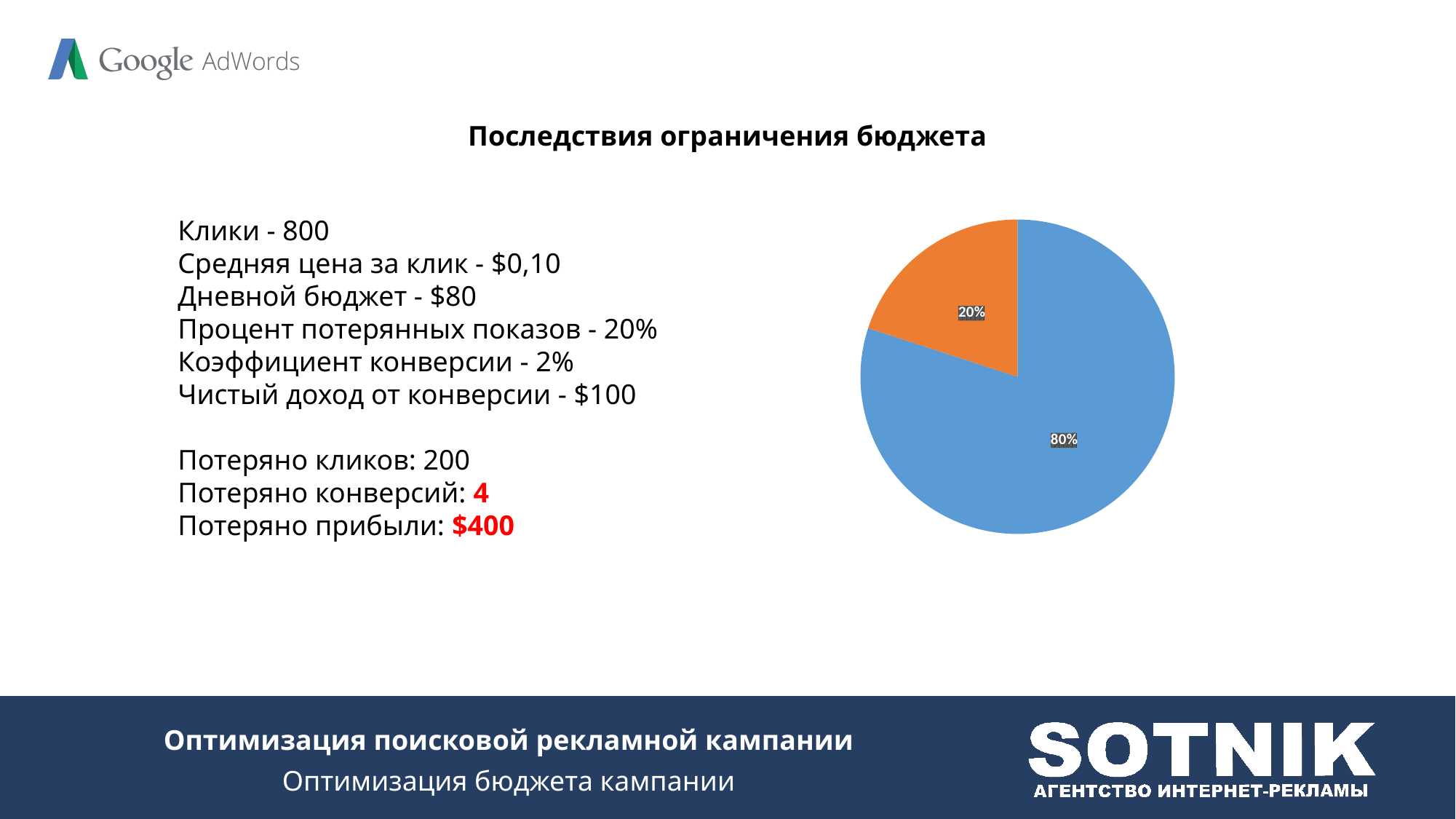
What share of the pie does the blue slice represent? 80% Which slice of the pie chart is the smallest? the orange slice (20%) Which is larger in the pie chart, the blue slice or the orange slice? the blue slice What percentage is shown on the blue slice of the pie chart? 80% By how many percentage points is the blue slice larger than the orange slice? 60 percentage points Which slice of the pie chart is the largest? the blue slice (80%) What percentage is shown on the orange slice of the pie chart? 20% What kind of chart is shown on the slide? pie chart Does the pie chart have a legend? No How many slices does the pie chart have? 2 What share of the pie does the orange slice represent? 20% What colours are used for the two slices of the pie chart? blue and orange